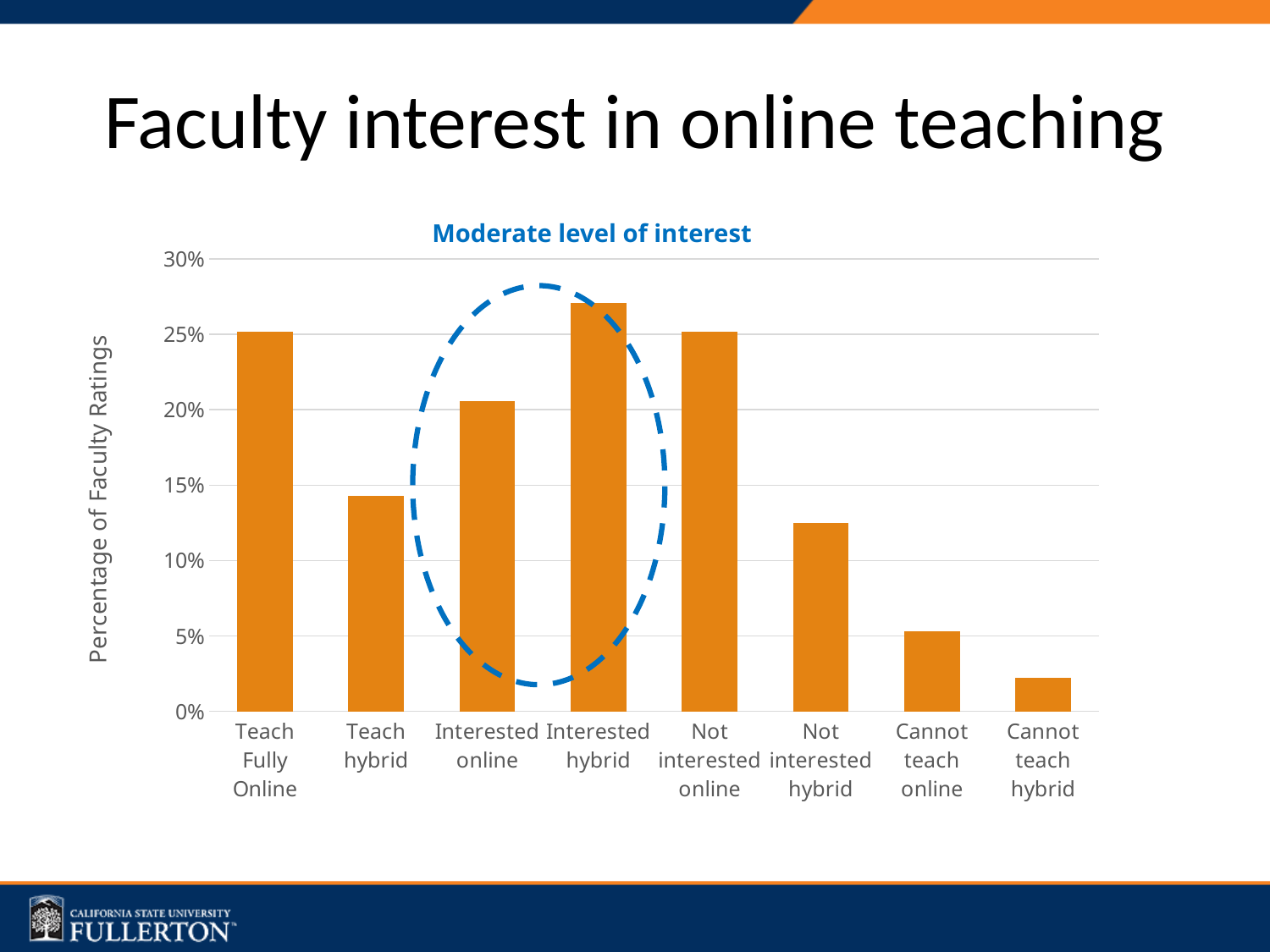
Is the value for Not interested hybrid greater or less than 15%? less Is the value for Cannot teach online greater or less than 10%? less What kind of chart is shown on the slide? bar chart Which category has the highest percentage of faculty ratings? Interested hybrid What is the label on the y axis of the chart? Percentage of Faculty Ratings Which category has the lowest percentage of faculty ratings? Cannot teach hybrid What is the title of the chart? Moderate level of interest Which is larger, the value for Interested online or the value for Teach hybrid? Interested online How many categories are shown on the x axis of the chart? 8 Is the value for Teach hybrid greater or less than 10%? greater Which is larger, the value for Cannot teach online or the value for Cannot teach hybrid? Cannot teach online